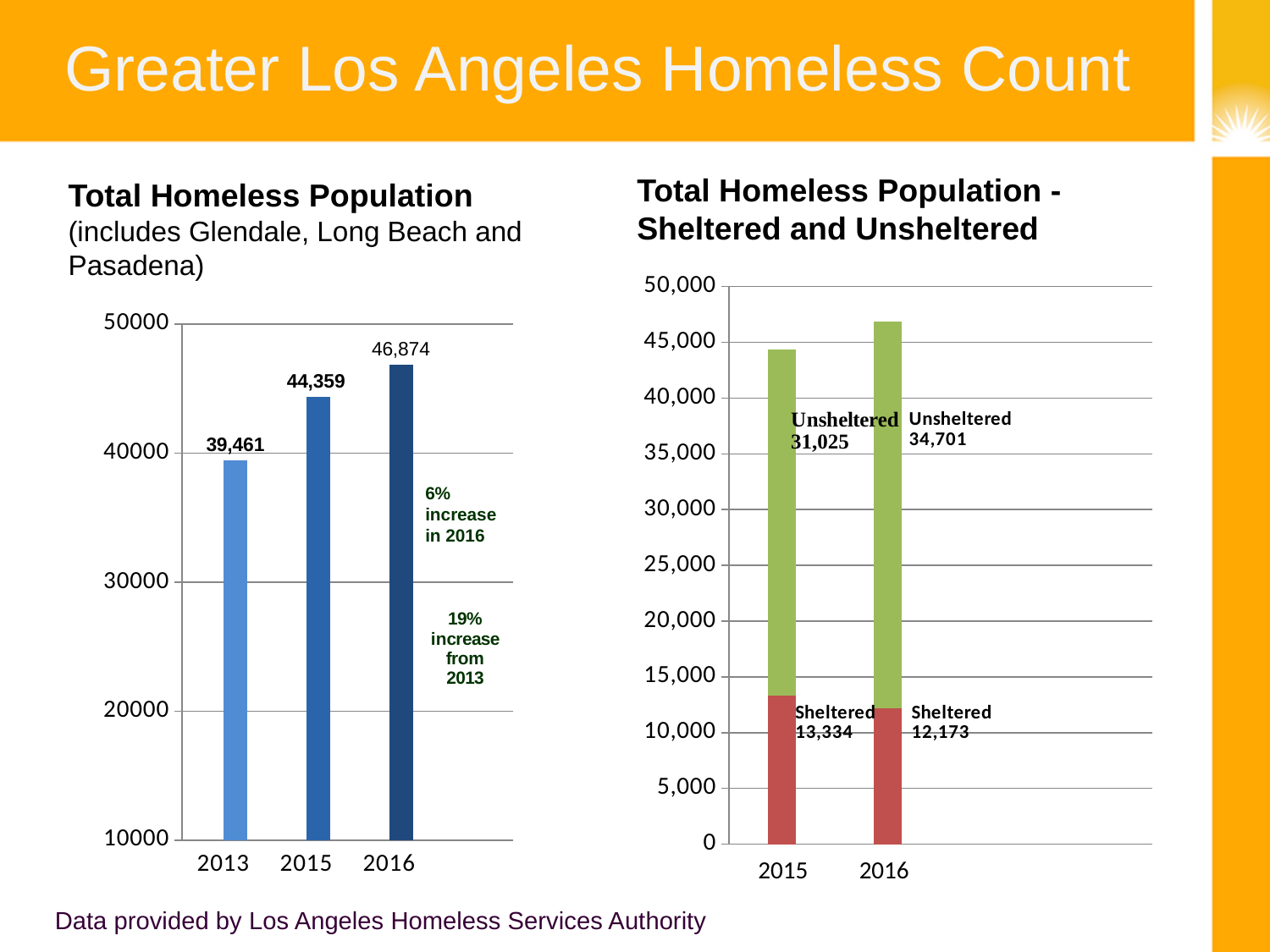
In the 'Total Homeless Population' chart, which year has the highest value? 2016 In the 'Total Homeless Population - Sheltered and Unsheltered' chart, what is the Sheltered value for 2015? 13,334 In the 'Total Homeless Population - Sheltered and Unsheltered' chart, what is the total of the stacked bar for 2016? 46,874 In the 'Total Homeless Population - Sheltered and Unsheltered' chart, is the Sheltered value larger in 2015 or 2016? 2015 What kind of chart is the 'Total Homeless Population - Sheltered and Unsheltered' chart? stacked bar chart In the 'Total Homeless Population' chart, how many years are plotted? 3 In the 'Total Homeless Population' chart, do the values rise or fall from 2013 to 2016? rise In the 'Total Homeless Population' chart, what is the difference between the 2016 and 2015 values? 2,515 In the 'Total Homeless Population - Sheltered and Unsheltered' chart, what is the Unsheltered value for 2016? 34,701 In the 'Total Homeless Population' chart, what is the value for 2013? 39,461 In the 'Total Homeless Population' chart, which year has the lowest value? 2013 In the 'Total Homeless Population' chart, what is the value for 2016? 46,874